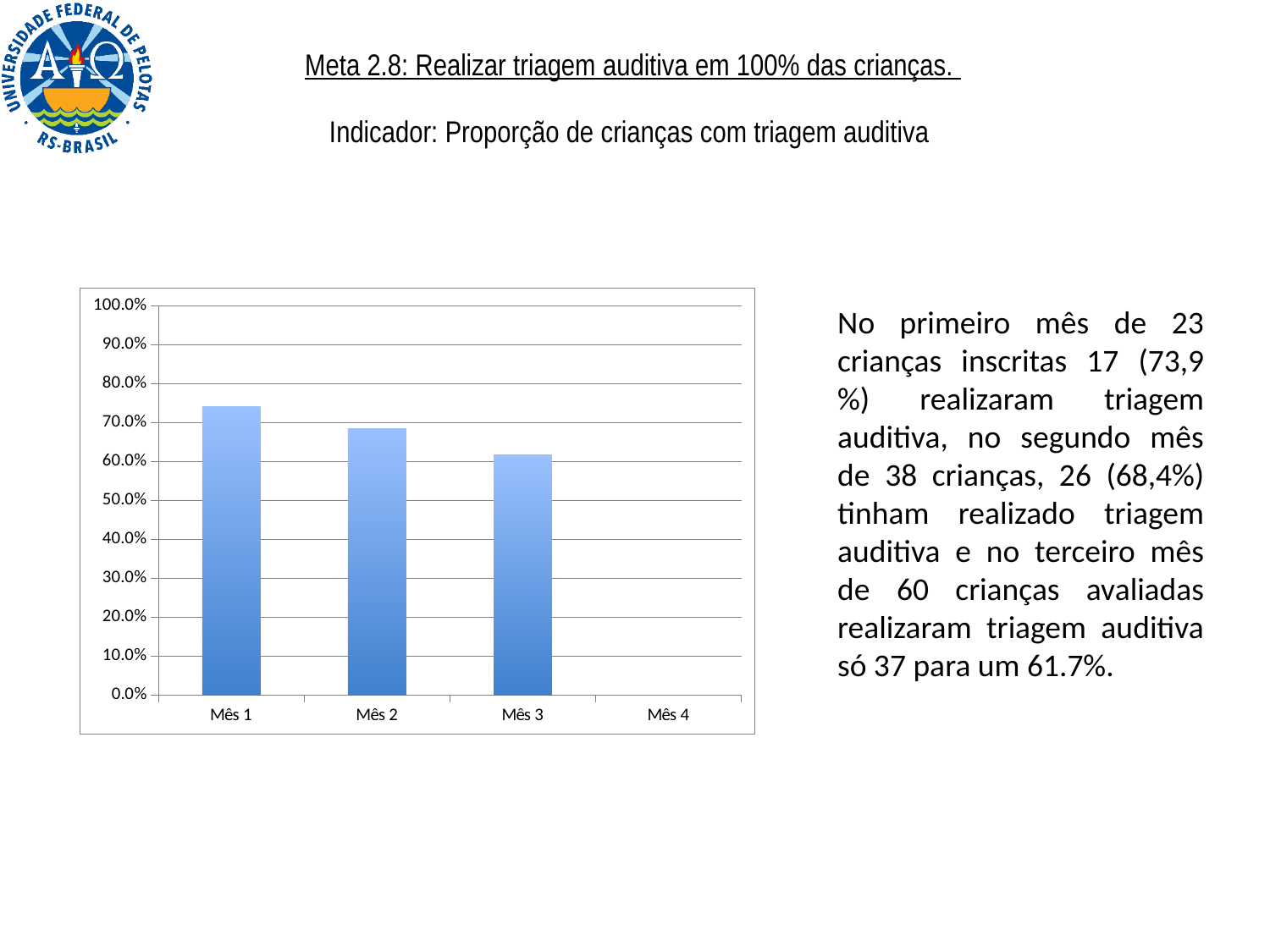
Is the value for Mês 1 greater or less than 70.0%? greater How many categories are shown on the x axis of the chart? 4 What is the maximum value shown on the y axis of the chart? 100.0% Which is larger, the value for Mês 1 or the value for Mês 3? Mês 1 Do the values rise or fall from Mês 1 to Mês 3? fall Which month has the highest bar in the chart? Mês 1 Is the value for Mês 3 greater or less than 60.0%? greater Which month on the x axis has no bar plotted? Mês 4 Is the value for Mês 3 greater or less than 70.0%? less Among the months that have a bar, which has the lowest value? Mês 3 What kind of chart is shown on the slide? bar chart